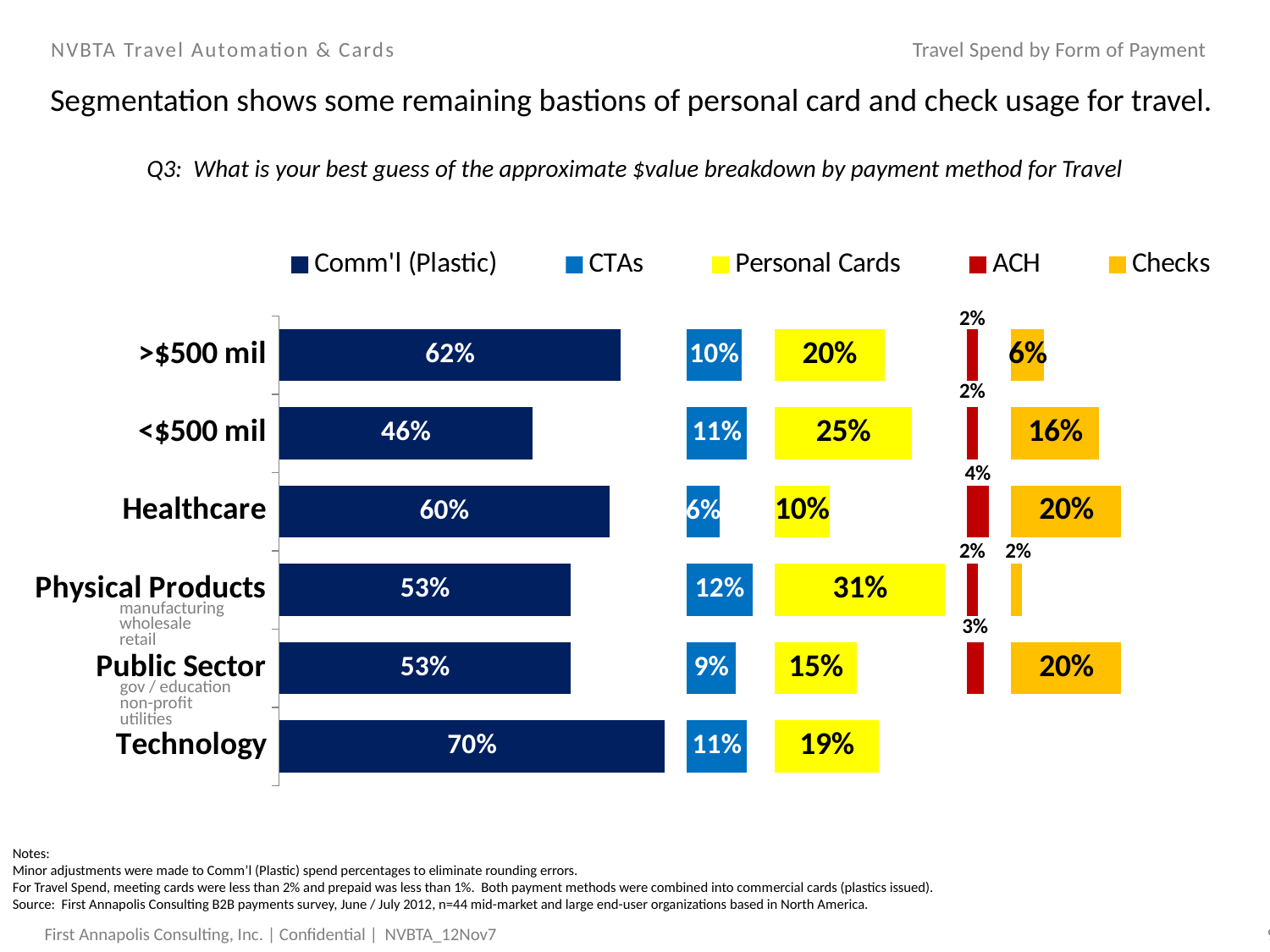
What is the Checks share for <$500 mil? 16% What is the Personal Cards share for Physical Products? 31% Which category has the highest Comm'l (Plastic) share? Technology What is the Comm'l (Plastic) share for Technology? 70% What is the difference between the Personal Cards share for Physical Products and for Healthcare? 21% What kind of chart is shown? Stacked bar chart How many categories are shown on the y axis? 6 What is the ACH share for Healthcare? 4% Which category has the lowest Comm'l (Plastic) share? <$500 mil Which is larger, the CTAs share for Physical Products or for Public Sector? Physical Products How many series does the legend list? 5 What colour represents Checks in the legend? Orange